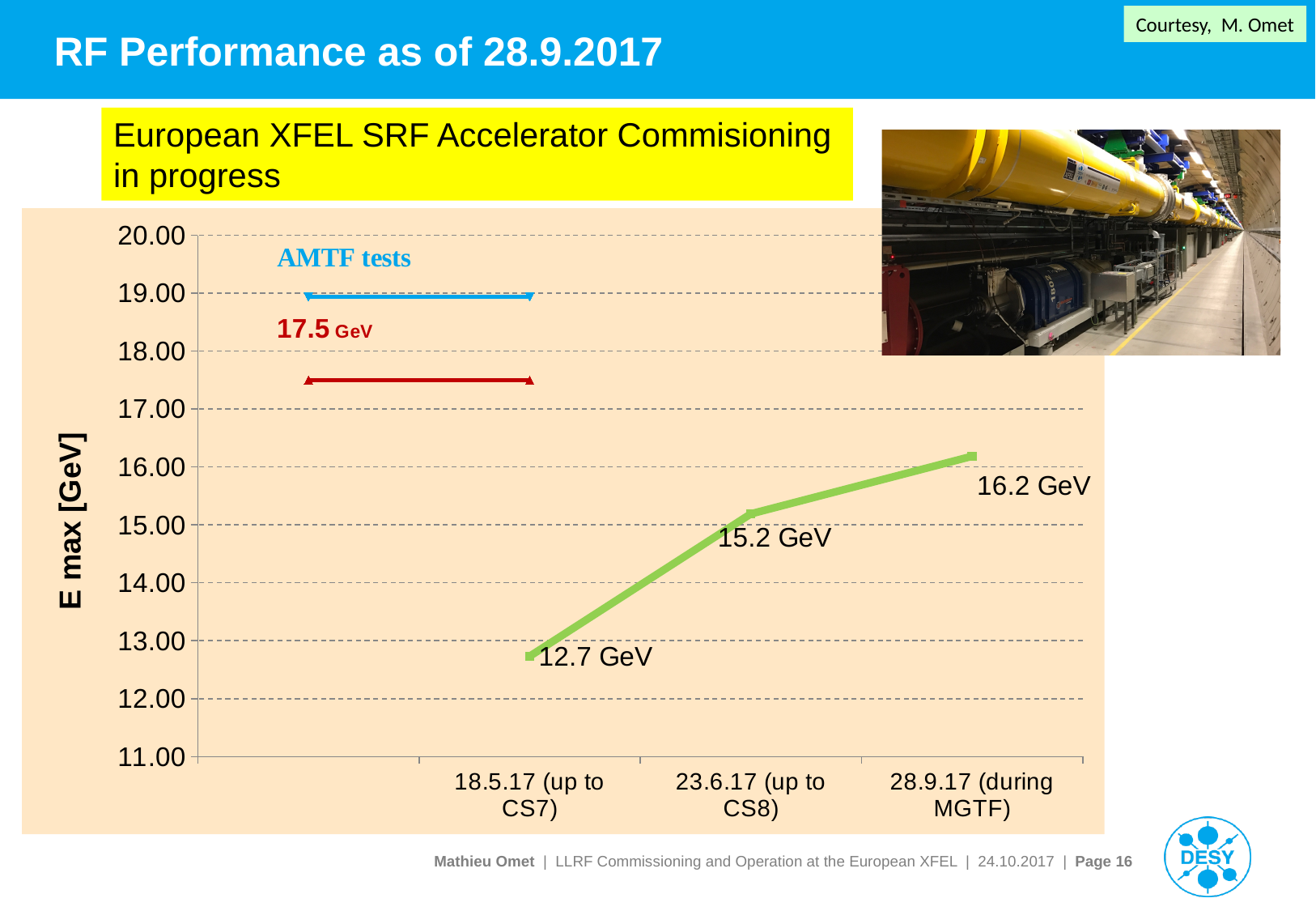
What is the E max value for 28.9.17 (during MGTF)? 16.2 GeV What is the E max value for 18.5.17 (up to CS7)? 12.7 GeV What is the difference in E max between 23.6.17 (up to CS8) and 18.5.17 (up to CS7)? 2.5 GeV What is the difference in E max between 28.9.17 (during MGTF) and 18.5.17 (up to CS7)? 3.5 GeV How many dated data points are plotted on the green line? 3 What is the E max value for 23.6.17 (up to CS8)? 15.2 GeV Which date has the highest E max value on the green line? 28.9.17 (during MGTF) Which date has the lowest E max value on the green line? 18.5.17 (up to CS7) Does the E max value rise or fall from 18.5.17 to 28.9.17? rise Which is larger, the E max for 23.6.17 (up to CS8) or for 28.9.17 (during MGTF)? 28.9.17 (during MGTF) Is the AMTF tests level shown on the chart greater or less than 18.00 GeV? greater What kind of chart is shown on the slide? line chart